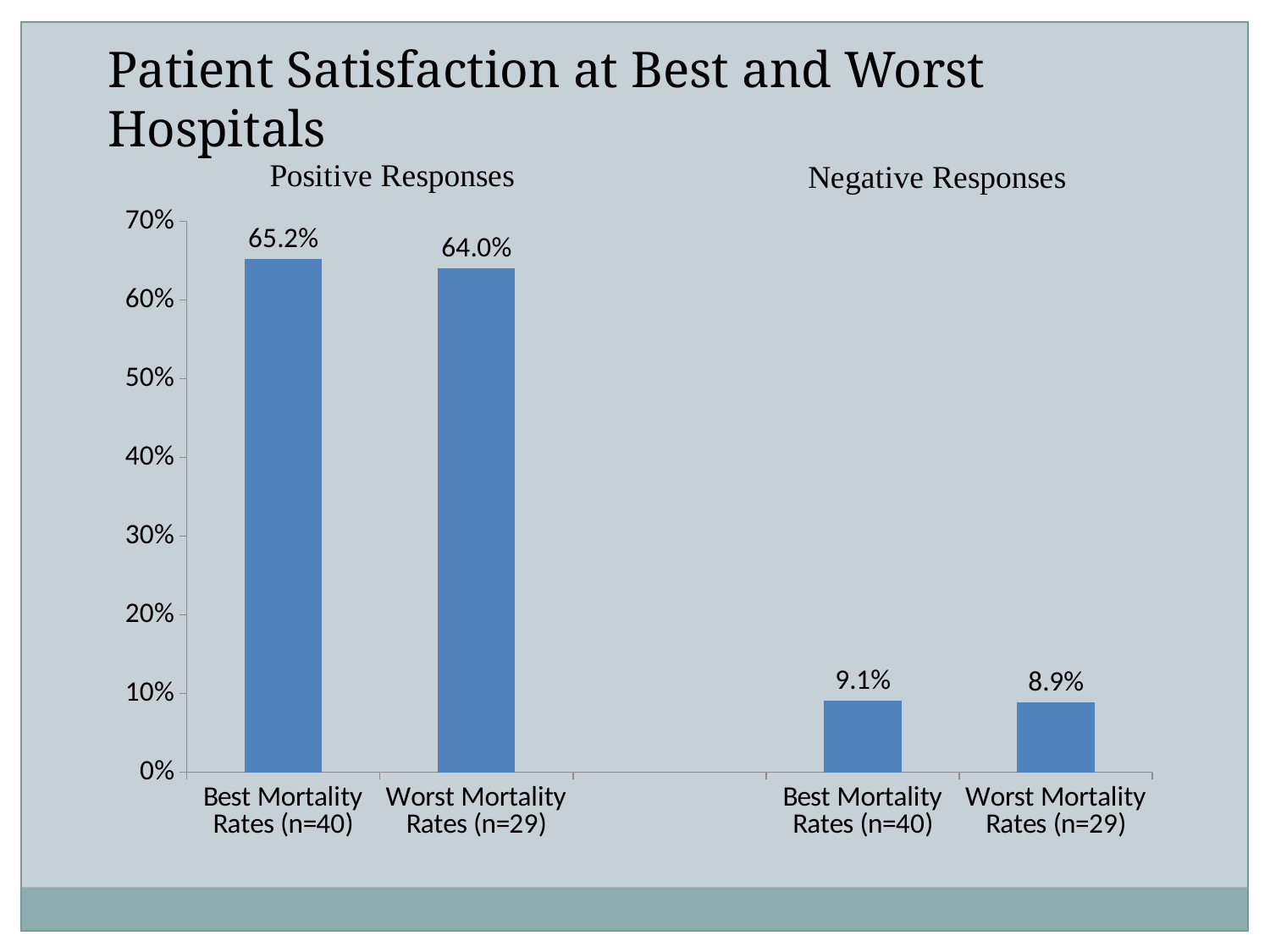
How many bars are plotted on the chart? 4 What is the title of the slide? Patient Satisfaction at Best and Worst Hospitals What is the positive response rate for hospitals with the best mortality rates (n=40)? 65.2% Which bar has the lowest value on the chart? Negative Responses, Worst Mortality Rates (n=29) Which bar has the highest value on the chart? Positive Responses, Best Mortality Rates (n=40) What is the difference in negative response rates between the best mortality rate hospitals and the worst mortality rate hospitals? 0.2% What is the negative response rate for hospitals with the best mortality rates (n=40)? 9.1% What is the positive response rate for hospitals with the worst mortality rates (n=29)? 64.0% What is the negative response rate for hospitals with the worst mortality rates (n=29)? 8.9% What type of chart is shown on the slide? Bar chart Which is larger: the negative response rate for best mortality rate hospitals or for worst mortality rate hospitals? Best Mortality Rates (n=40) What is the difference in positive response rates between the best mortality rate hospitals and the worst mortality rate hospitals? 1.2%